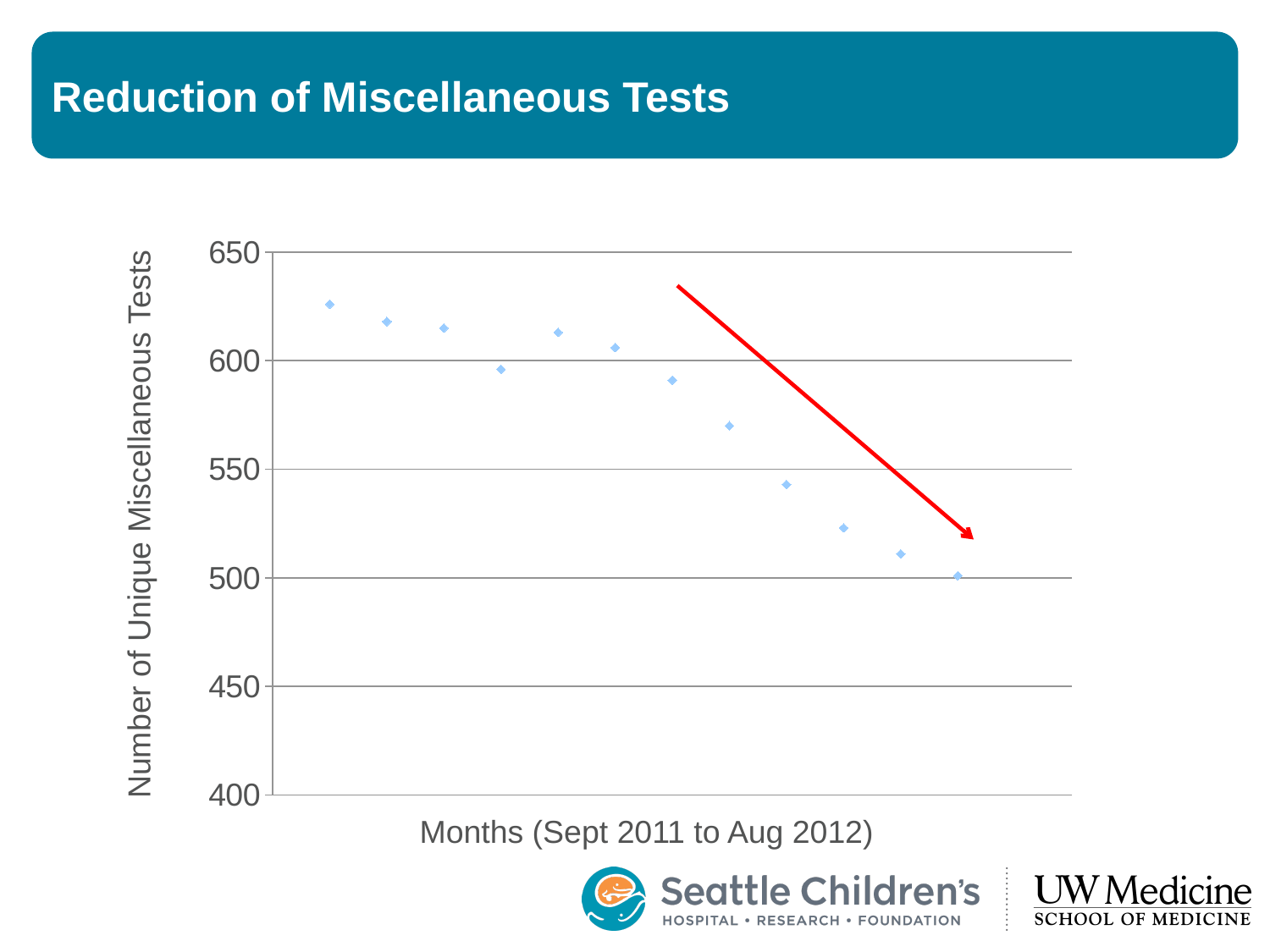
What is the title of the slide's chart? Reduction of Miscellaneous Tests Is the value of the tenth point from the left greater or less than 550? less Which point on the chart has the lowest value? The last (rightmost) point Do the values generally rise or fall from left to right along the x axis? Fall What is the label on the x axis? Months (Sept 2011 to Aug 2012) How many data points are plotted on the chart? 12 Is the value of the eighth point from the left greater or less than 550? greater Is the value of the last (rightmost) point greater or less than 550? less Which point has the highest value, the first or the last? The first What kind of chart is shown on the slide? Scatter chart